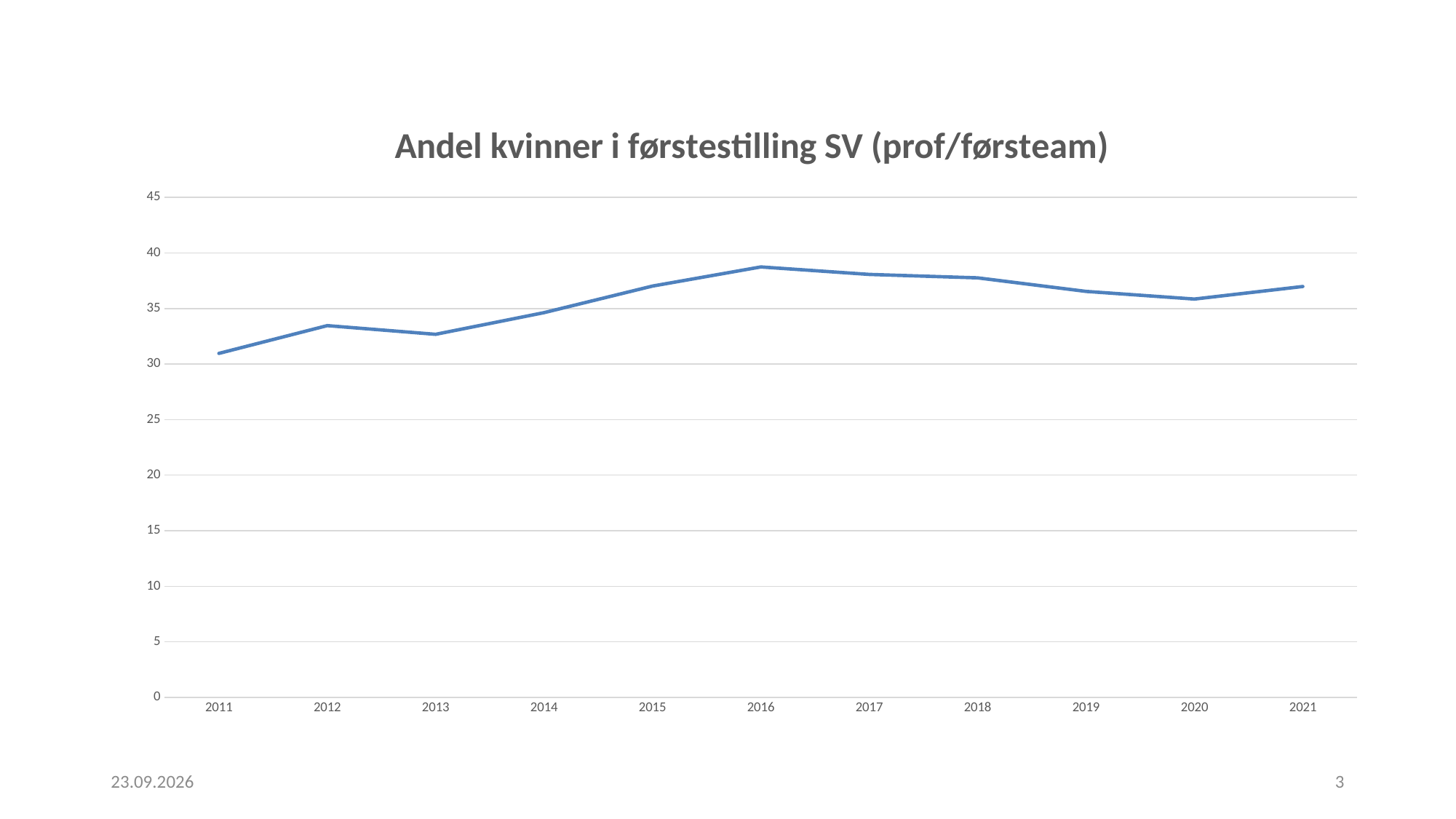
What is the title of the chart? Andel kvinner i førstestilling SV (prof/førsteam) Is the value for 2011 greater or less than 35? less Which year has the larger value, 2016 or 2020? 2016 In which year is the value highest? 2016 Do the values rise or fall from 2011 to 2016? rise Is the value for 2016 greater or less than 35? greater In which year is the value lowest? 2011 Is the value for 2016 greater or less than 40? less Which year has the larger value, 2015 or 2011? 2015 How many years are plotted along the x axis? 11 What kind of chart is shown on the slide? Line chart